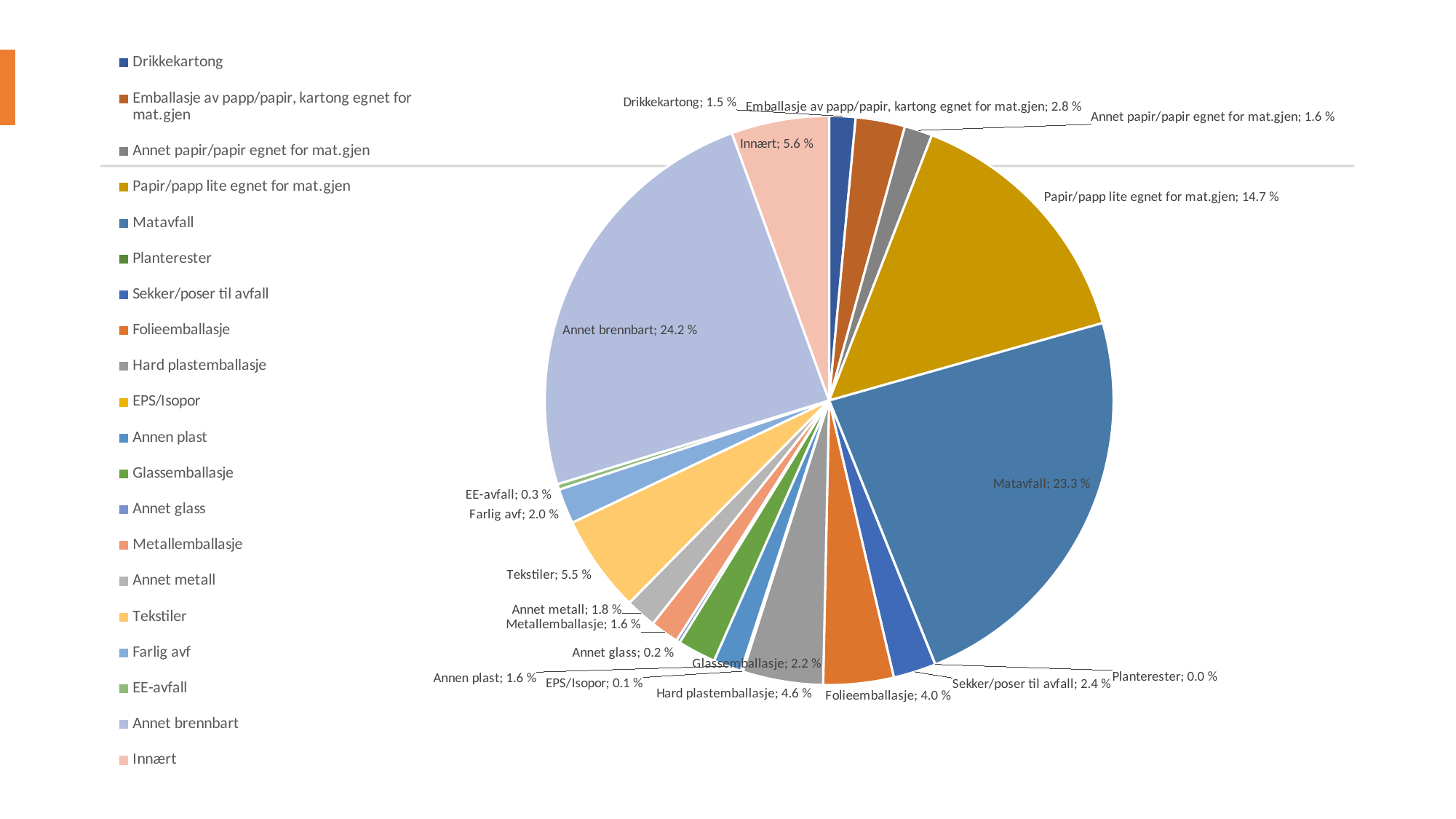
What kind of chart is shown on the slide? pie chart What is the value shown for Papir/papp lite egnet for mat.gjen? 14.7 % What is the difference between the values for Annet brennbart and Matavfall? 0.9 % What is the value shown for EE-avfall? 0.3 % What is the value shown for Tekstiler? 5.5 % Which category has the largest slice of the pie? Annet brennbart Which is larger, Folieemballasje or Hard plastemballasje? Hard plastemballasje What share of the pie does Matavfall have? 23.3 % Which category has the smallest slice of the pie? Planterester What is the difference between the values for Innært and Tekstiler? 0.1 % How many categories does the pie chart have? 20 What is the value shown for Hard plastemballasje? 4.6 %